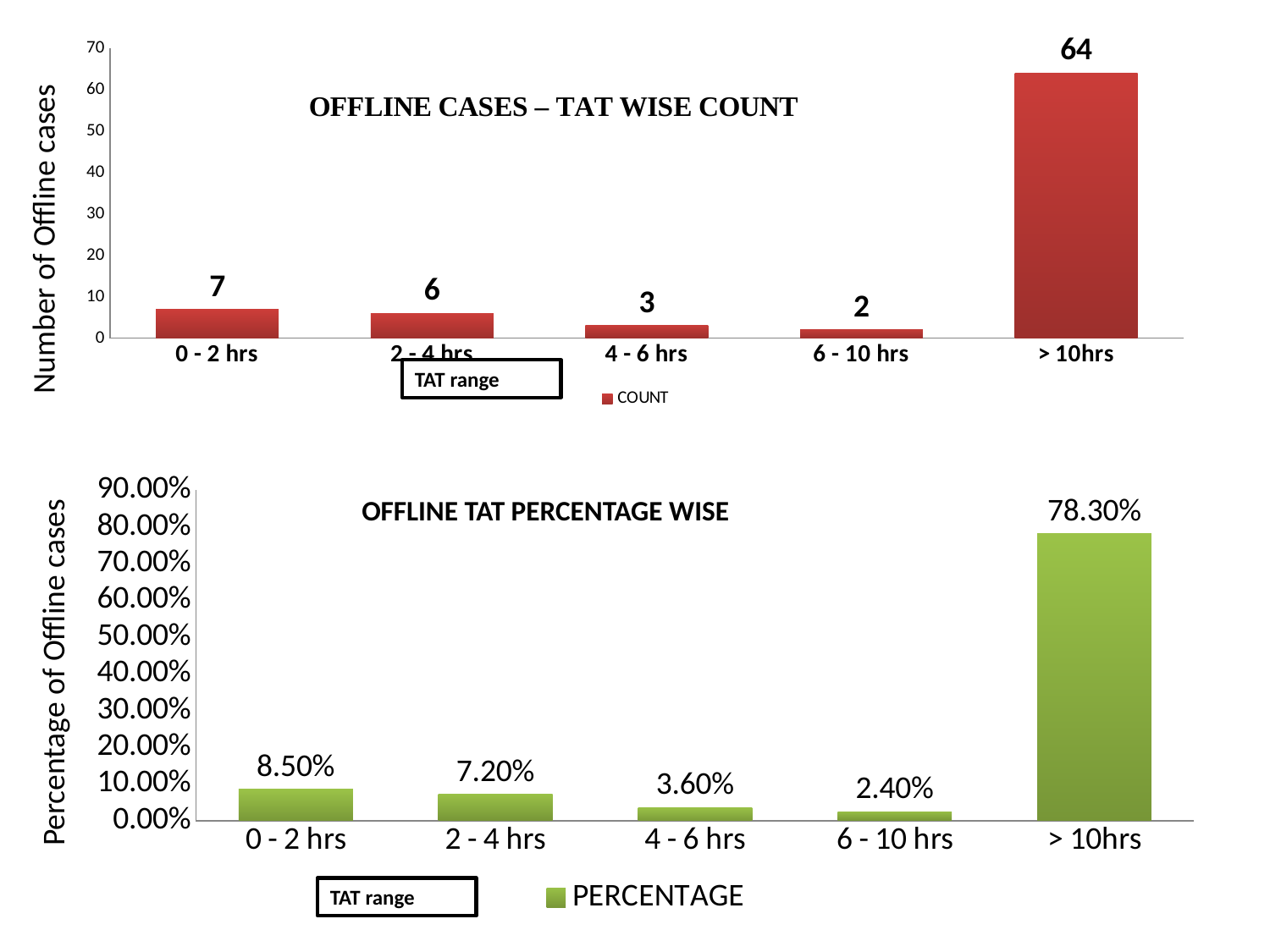
In the 'OFFLINE TAT PERCENTAGE WISE' chart, what is the value for '> 10hrs'? 78.30% In the 'OFFLINE TAT PERCENTAGE WISE' chart, what is the value for '2 - 4 hrs'? 7.20% In the 'OFFLINE CASES – TAT WISE COUNT' chart, what is the value for '> 10hrs'? 64 In the 'OFFLINE CASES – TAT WISE COUNT' chart, what series name does the legend show? COUNT In the 'OFFLINE TAT PERCENTAGE WISE' chart, which is larger, the value for '0 - 2 hrs' or the value for '4 - 6 hrs'? 0 - 2 hrs What kind of chart is the 'OFFLINE TAT PERCENTAGE WISE' chart? Bar chart In the 'OFFLINE CASES – TAT WISE COUNT' chart, what is the value for '4 - 6 hrs'? 3 In the 'OFFLINE TAT PERCENTAGE WISE' chart, what is the difference between the values for '4 - 6 hrs' and '6 - 10 hrs'? 1.20% In the 'OFFLINE TAT PERCENTAGE WISE' chart, which TAT range has the highest percentage? > 10hrs In the 'OFFLINE CASES – TAT WISE COUNT' chart, what is the difference between the values for '0 - 2 hrs' and '2 - 4 hrs'? 1 In the 'OFFLINE CASES – TAT WISE COUNT' chart, how many TAT range categories are shown? 5 In the 'OFFLINE CASES – TAT WISE COUNT' chart, which TAT range has the lowest count? 6 - 10 hrs